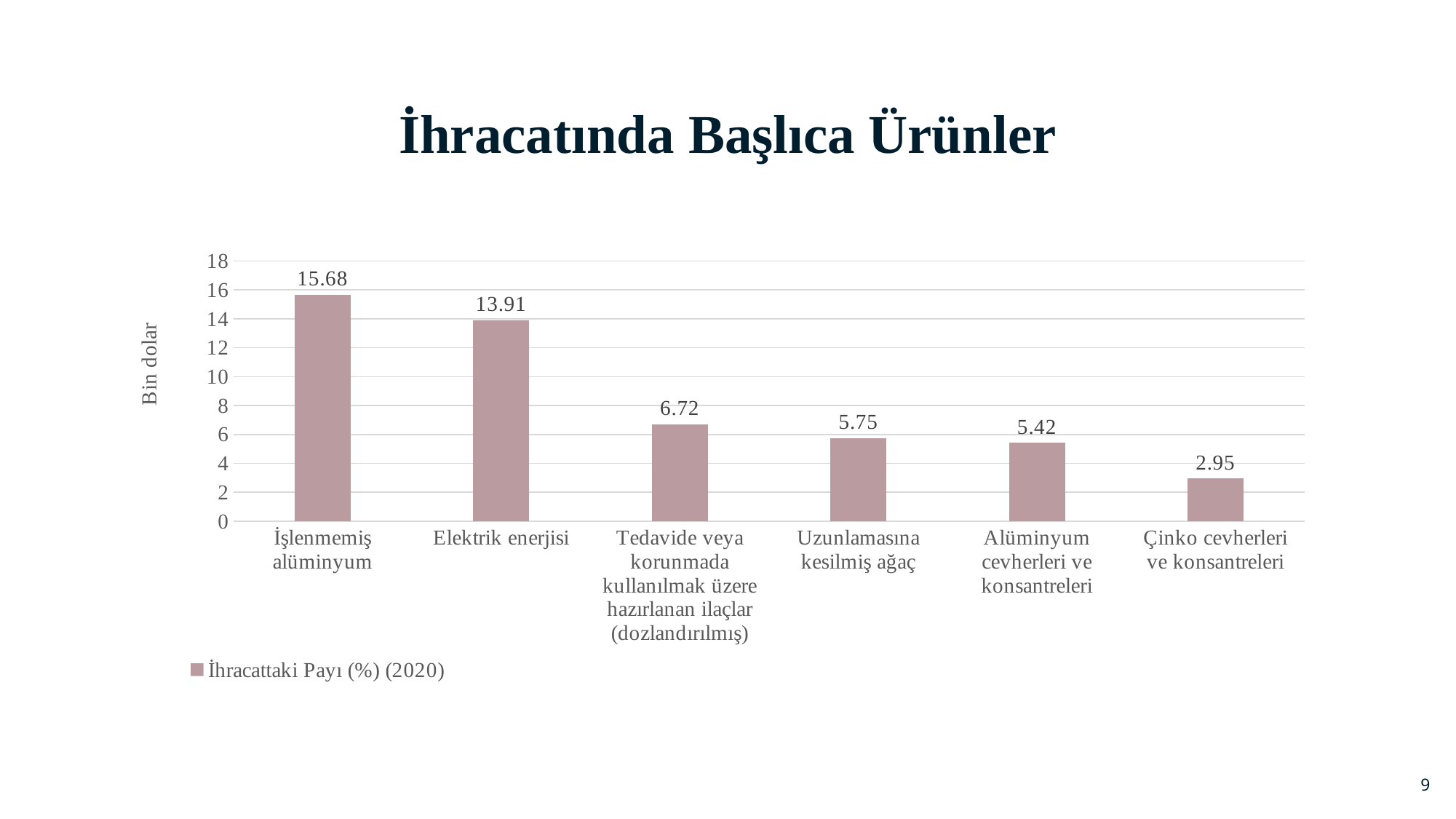
What is the legend entry for the series in the chart? İhracattaki Payı (%) (2020) Which is larger: the value for Uzunlamasına kesilmiş ağaç or the value for Alüminyum cevherleri ve konsantreleri? Uzunlamasına kesilmiş ağaç Which category has the highest value? İşlenmemiş alüminyum What is the value for Çinko cevherleri ve konsantreleri? 2.95 How many categories are shown in the chart? 6 What is the value for İşlenmemiş alüminyum? 15.68 Is the value for Tedavide veya korunmada kullanılmak üzere hazırlanan ilaçlar (dozlandırılmış) greater or less than 8? less What is the value for Alüminyum cevherleri ve konsantreleri? 5.42 What is the value for Elektrik enerjisi? 13.91 What kind of chart is shown on the slide? bar chart Which category has the lowest value? Çinko cevherleri ve konsantreleri What is the difference between the values for İşlenmemiş alüminyum and Elektrik enerjisi? 1.77